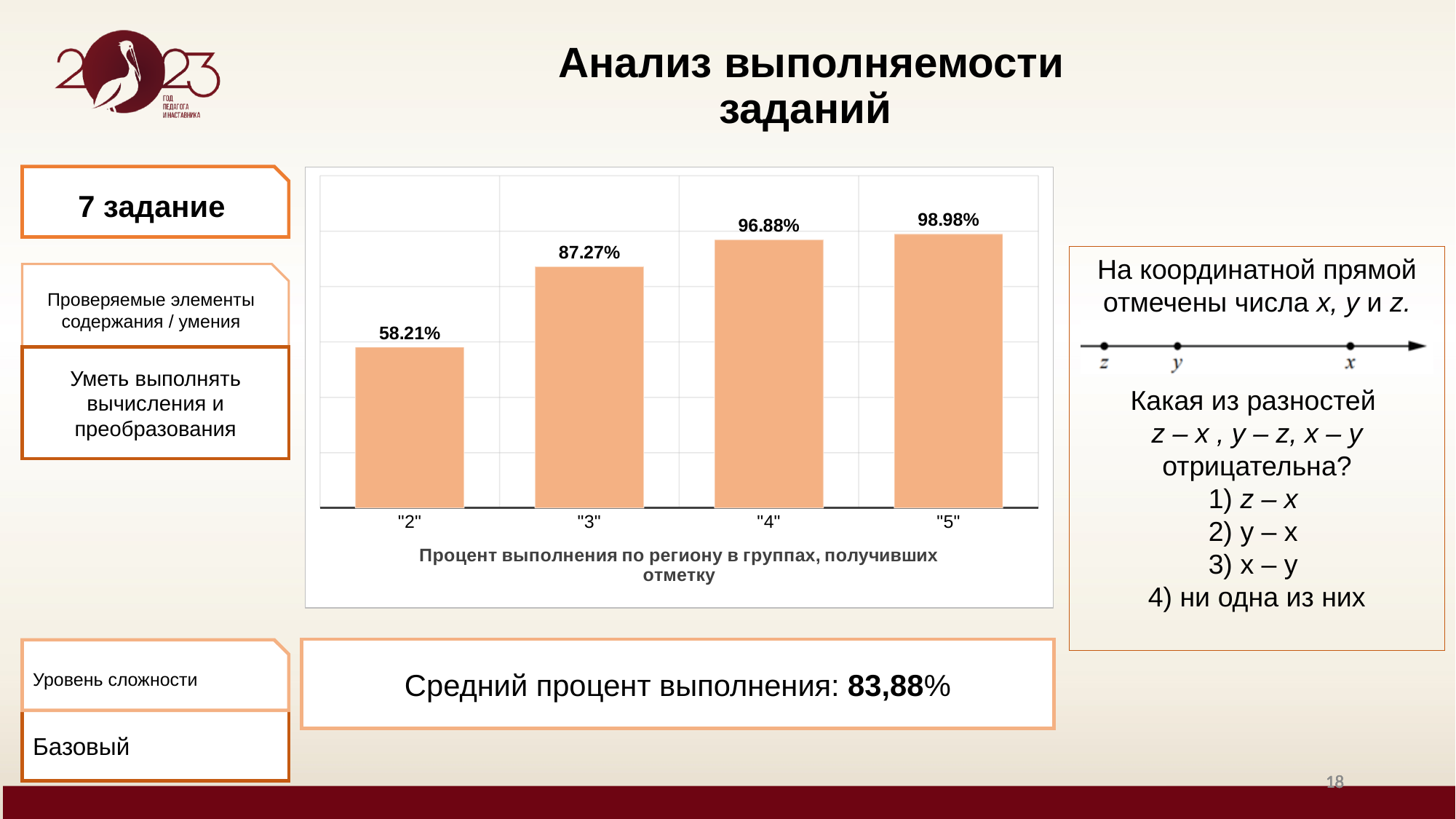
What is the value for the group with mark "2"? 58.21% What is the difference between the values for groups "5" and "2"? 40.77% What is the difference between the values for groups "4" and "3"? 9.61% Which is larger, the value for group "3" or the value for group "4"? "4" What is the value for the group with mark "3"? 87.27% Do the values rise or fall from group "2" to group "5"? Rise Which group has the lowest completion percentage? "2" What is the value for the group with mark "4"? 96.88% What is the value for the group with mark "5"? 98.98% Which group has the highest completion percentage? "5" How many categories are shown on the x axis? 4 What kind of chart is shown on the slide? Bar chart